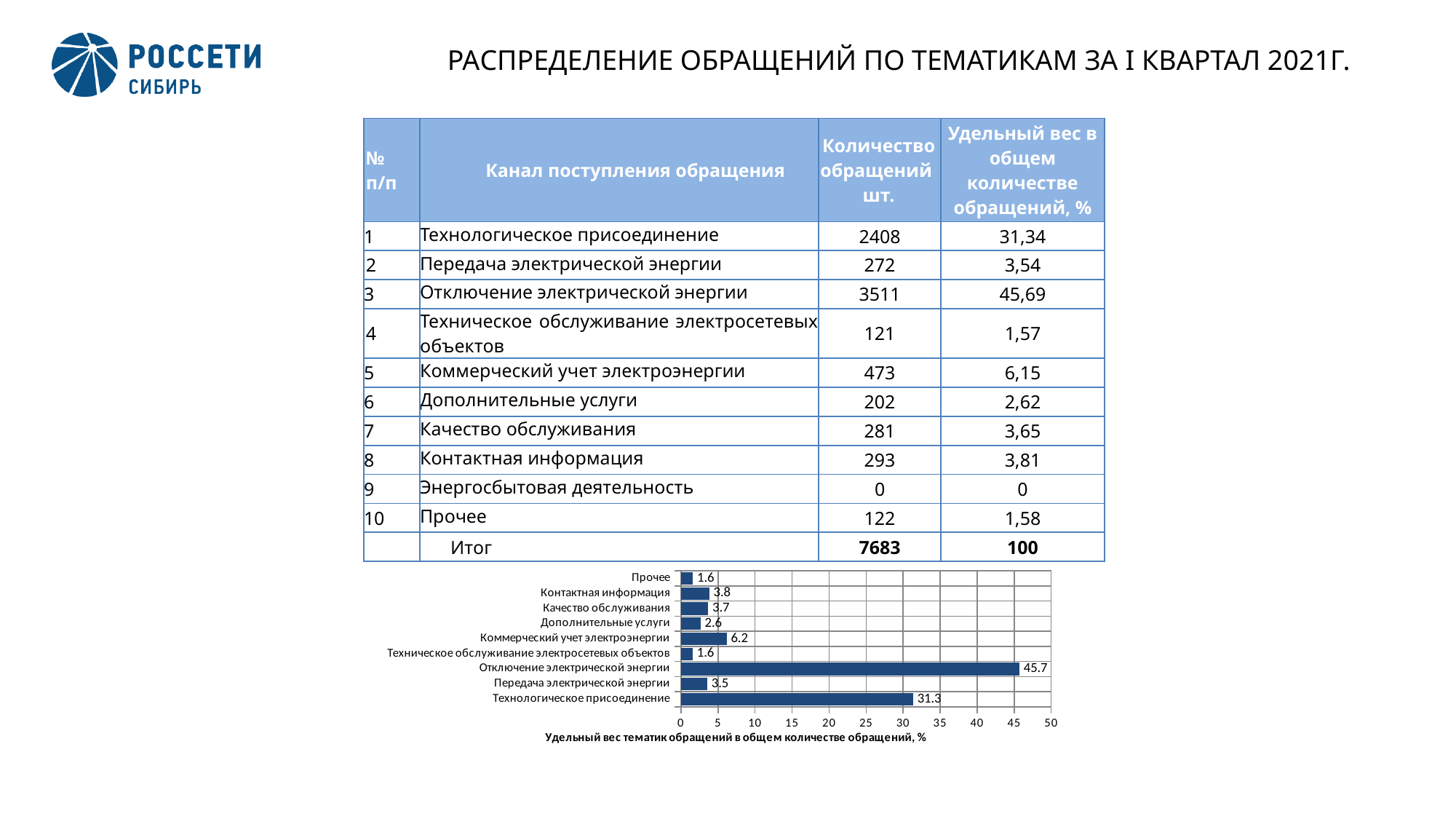
In the bar chart, what is the value for Отключение электрической энергии? 45.7 In the bar chart, which is larger: the value for Коммерческий учет электроэнергии or the value for Дополнительные услуги? Коммерческий учет электроэнергии How many categories are plotted in the bar chart? 9 In the bar chart, what is the value for Технологическое присоединение? 31.3 In the bar chart, what is the difference between the values for Отключение электрической энергии and Технологическое присоединение? 14.4 In the bar chart, which category has the highest value? Отключение электрической энергии In the bar chart, what is the value for Коммерческий учет электроэнергии? 6.2 In the bar chart, what is the value for Контактная информация? 3.8 What kind of chart is shown below the table on the slide? bar chart What is the axis title shown under the bar chart? Удельный вес тематик обращений в общем количестве обращений, % In the bar chart, is the value for Технологическое присоединение greater or less than 30? greater In the bar chart, what is the value for Передача электрической энергии? 3.5